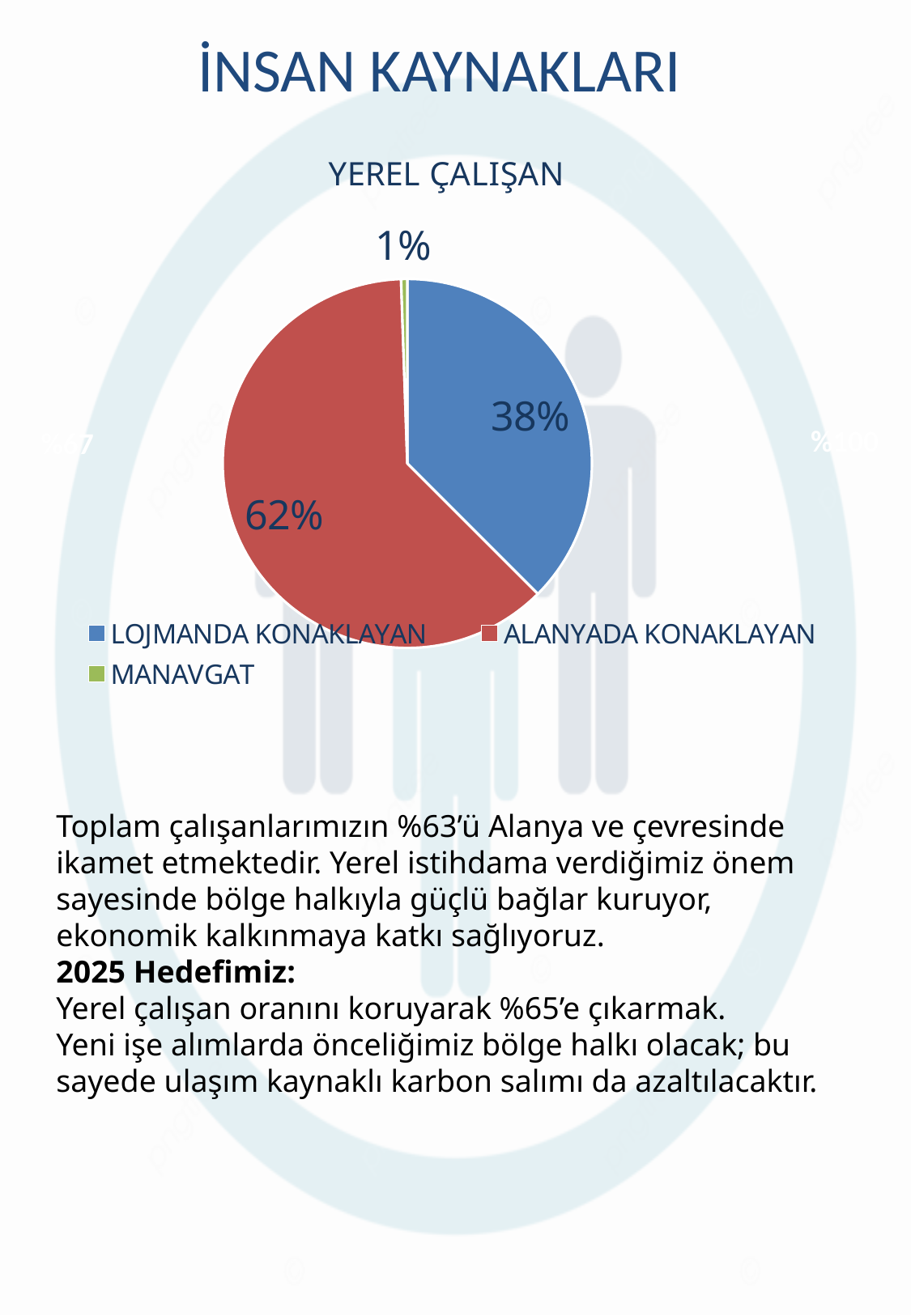
Which category has the largest slice of the pie? ALANYADA KONAKLAYAN How many categories does the pie chart have? 3 What share of the pie does ALANYADA KONAKLAYAN represent? 62% What type of chart is shown on the slide? pie chart What share of the pie does MANAVGAT represent? 1% Which is larger, the LOJMANDA KONAKLAYAN slice or the MANAVGAT slice? LOJMANDA KONAKLAYAN What is the title of the chart? YEREL ÇALIŞAN What colour is the ALANYADA KONAKLAYAN slice? red How many entries does the legend list? 3 Which category has the smallest slice of the pie? MANAVGAT What is the difference between the ALANYADA KONAKLAYAN and LOJMANDA KONAKLAYAN shares? 24% What share of the pie does LOJMANDA KONAKLAYAN represent? 38%